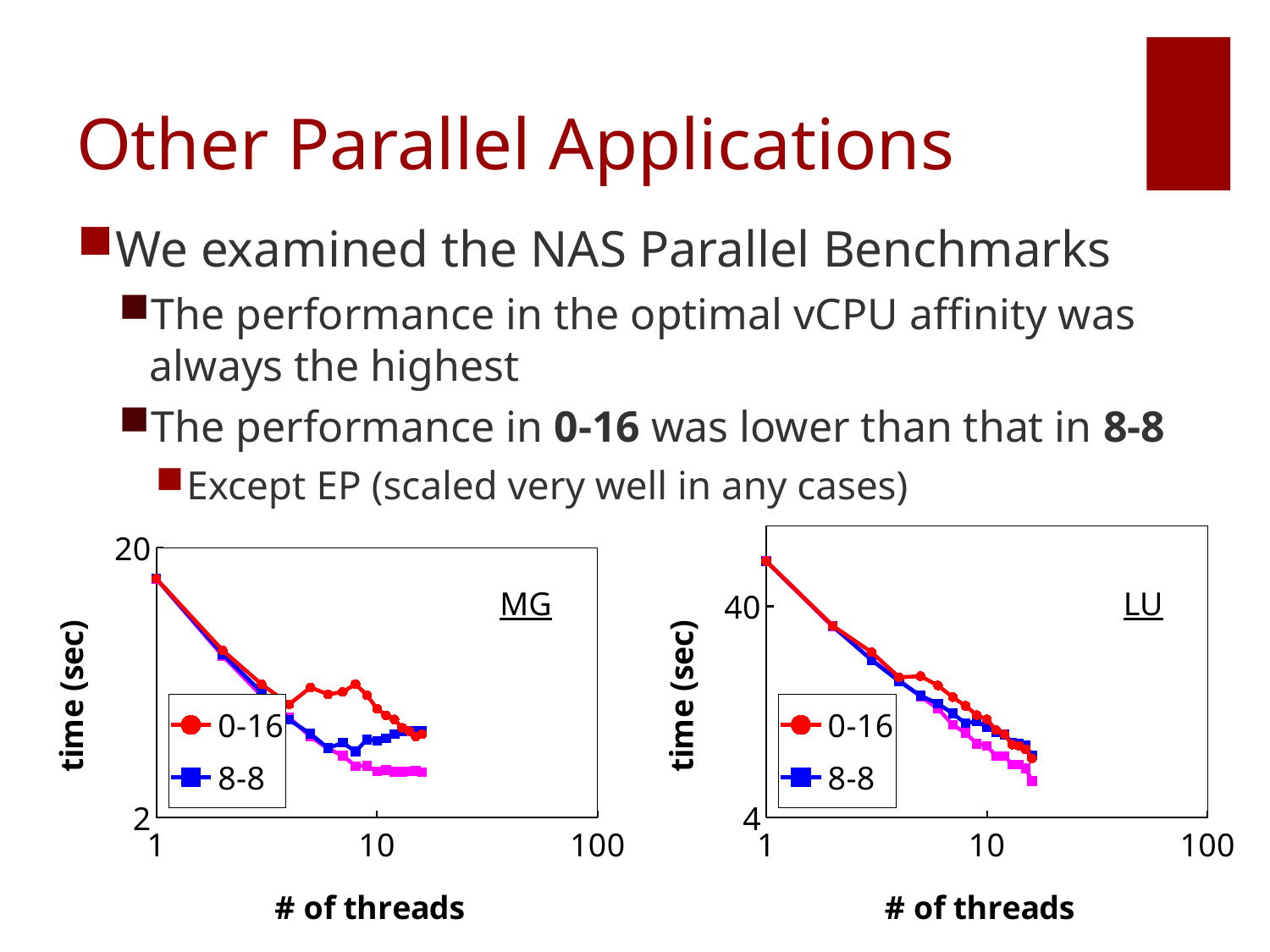
In the MG chart, at 8 threads, which series has the higher time, 0-16 or 8-8? 0-16 What kind of chart is the MG chart on the left? line chart What is the y-axis label of the LU chart? time (sec) In the MG chart, is the time for 0-16 at 1 thread greater or less than 20? less In the LU chart, is the time for 8-8 at 10 threads greater or less than 40? less In the MG chart, does the time for the 8-8 series rise or fall as the number of threads increases from 1 to 10? fall What is the x-axis label of the MG chart? # of threads In the LU chart, which series has the higher time at 5 threads, 0-16 or 8-8? 0-16 In the LU chart, does the time for the 0-16 series rise or fall as the number of threads increases? fall In the MG chart, is the time for 8-8 at 10 threads greater or less than 2? greater How many series does the legend of the LU chart list? 2